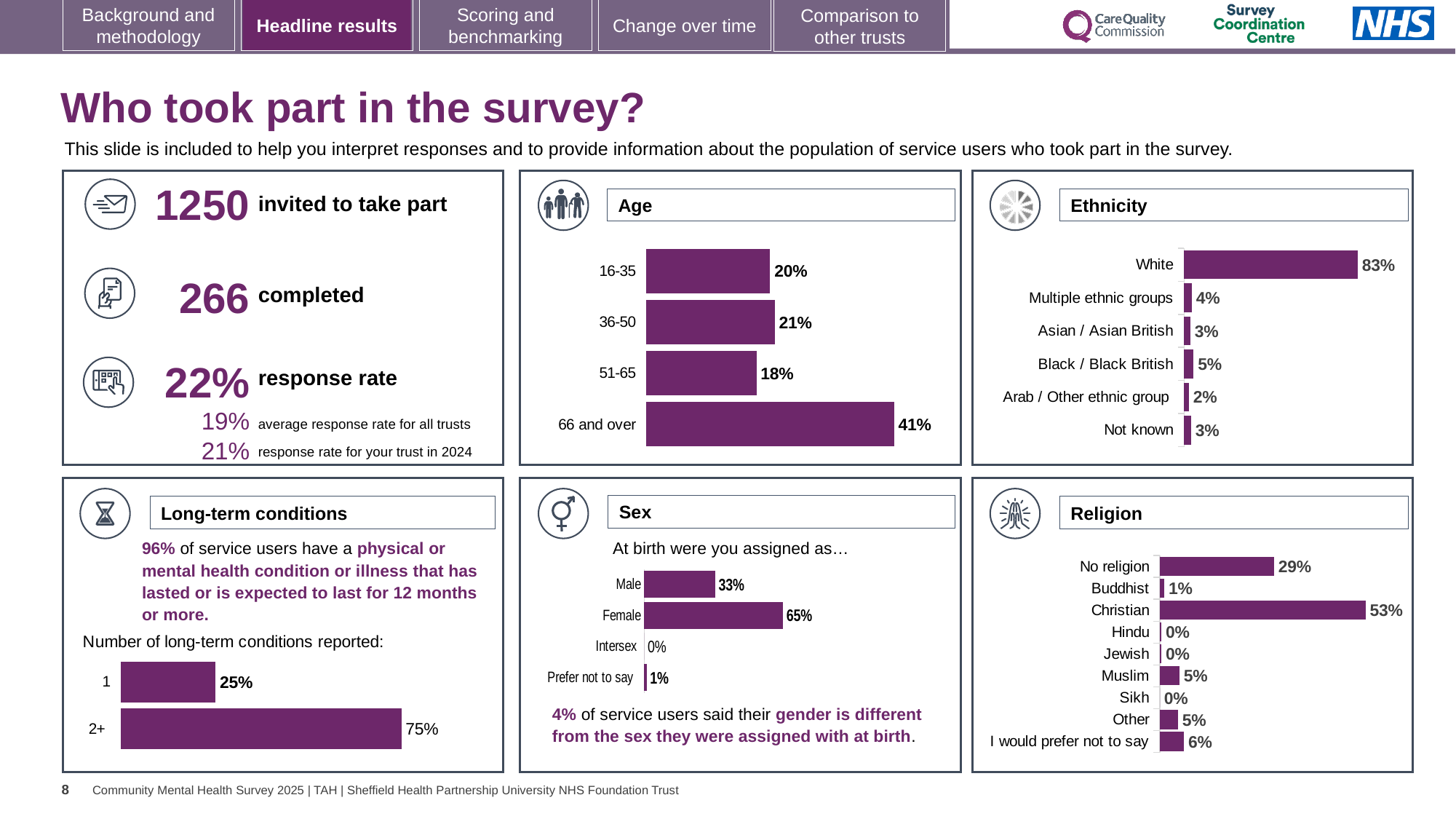
In the Religion chart, which category has the highest percentage? Christian In the Age chart, how many age groups are shown? 4 In the Ethnicity chart, which category has the lowest percentage? Arab / Other ethnic group In the Age chart, what percentage of respondents were aged 66 and over? 41% In the Religion chart, what percentage of respondents were Christian? 53% In the Ethnicity chart, what percentage of respondents were White? 83% In the Long-term conditions chart, what percentage of service users reported 2+ long-term conditions? 75% In the Age chart, which age group has the lowest percentage? 51-65 In the Religion chart, how many religion categories are listed? 9 In the Ethnicity chart, what is the difference between the White and Black / Black British percentages? 78% In the Sex chart, which is larger, Male or Female? Female In the Sex chart, what percentage of respondents were assigned Female at birth? 65%